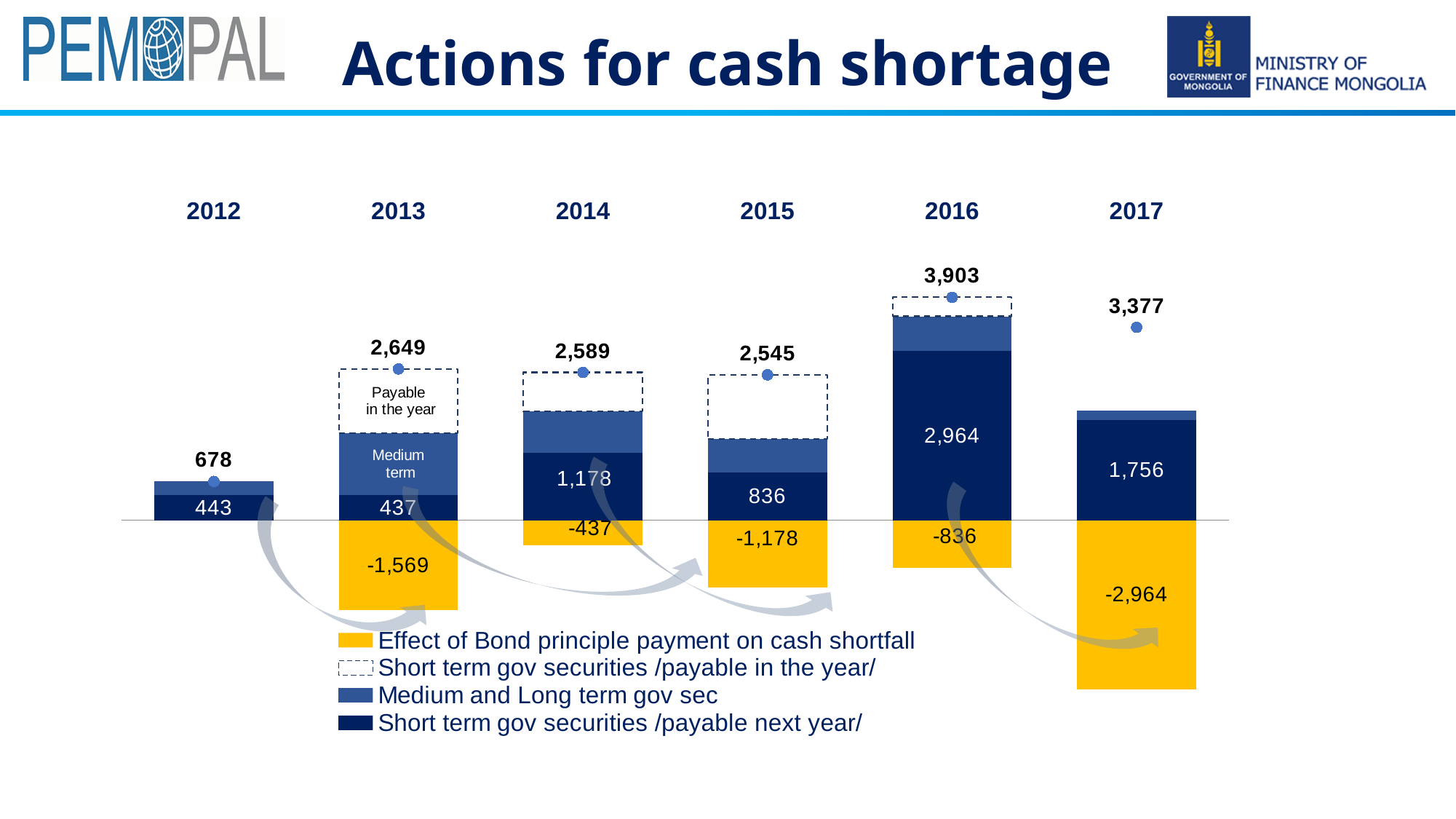
What kind of chart is shown on the slide? Stacked bar chart What is the total value marked above the 2016 bar? 3,903 What is the 'Effect of Bond principle payment on cash shortfall' value for 2013? -1,569 Which year has the highest total value marked above its bar? 2016 Which is larger, the 'Short term gov securities /payable next year/' value for 2015 or for 2017? 2017 How many years are shown along the x axis? 6 What is the 'Effect of Bond principle payment on cash shortfall' value for 2017? -2,964 What is the value of the 'Short term gov securities /payable next year/' segment for 2014? 1,178 Which year has the lowest total value marked above its bar? 2012 What is the difference between the total values for 2016 and 2017? 526 How many series does the legend list? 4 Which colour represents 'Effect of Bond principle payment on cash shortfall' in the legend? Yellow